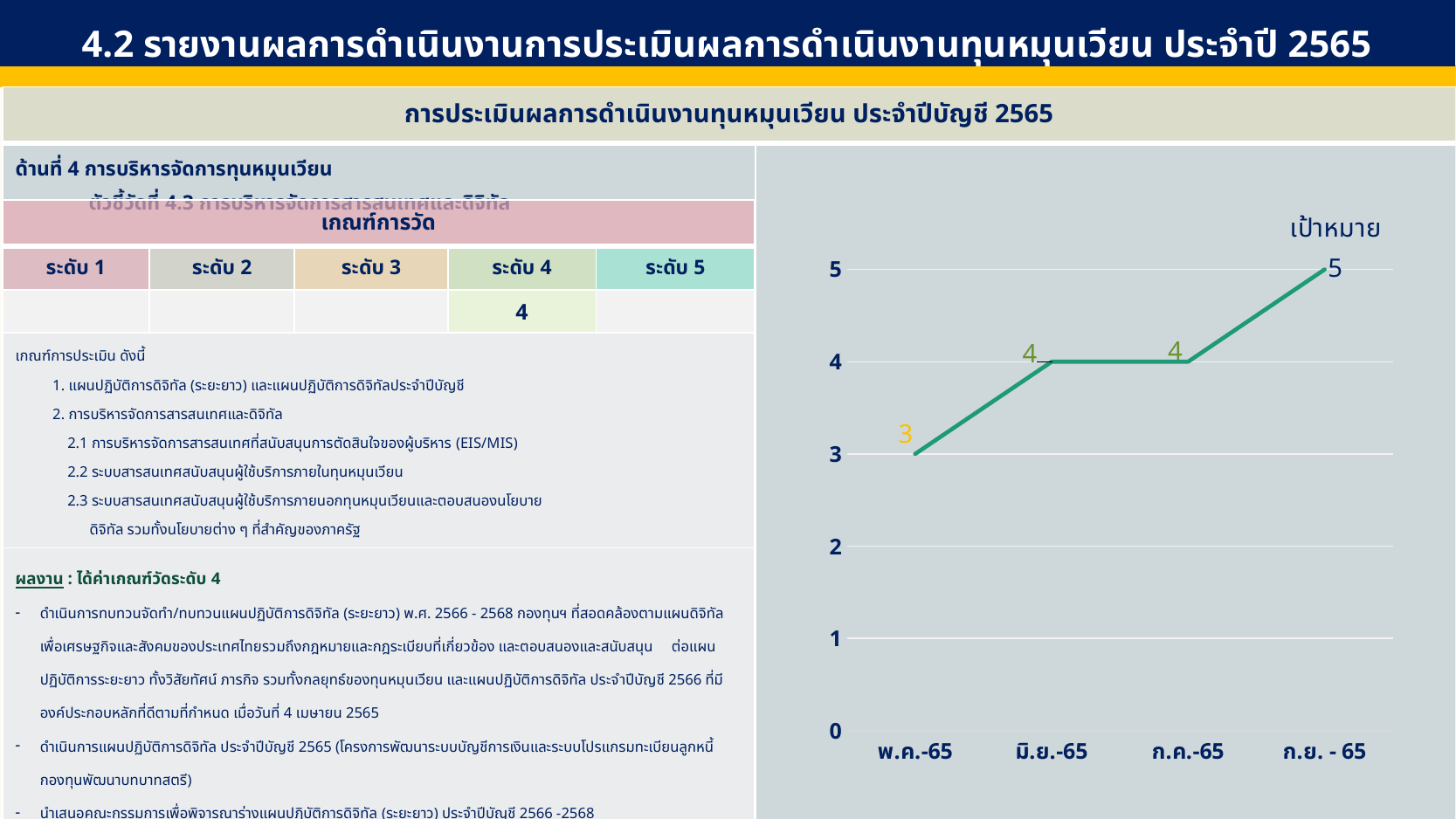
What is the value plotted for ก.ย. - 65? 5 What label is written above the last data point of the line chart? เป้าหมาย What is the value plotted for พ.ค.-65? 3 What kind of chart is shown on the right side of the slide? line chart Which month has the highest plotted value? ก.ย. - 65 What is the difference between the value for ก.ย. - 65 and the value for พ.ค.-65? 2 How many data points are plotted on the line chart? 4 What is the value plotted for ก.ค.-65? 4 What is the value plotted for มิ.ย.-65? 4 Which is larger, the value for มิ.ย.-65 or the value for ก.ย. - 65? ก.ย. - 65 Which month has the lowest plotted value? พ.ค.-65 Do the plotted values rise or fall from พ.ค.-65 to ก.ย. - 65? rise